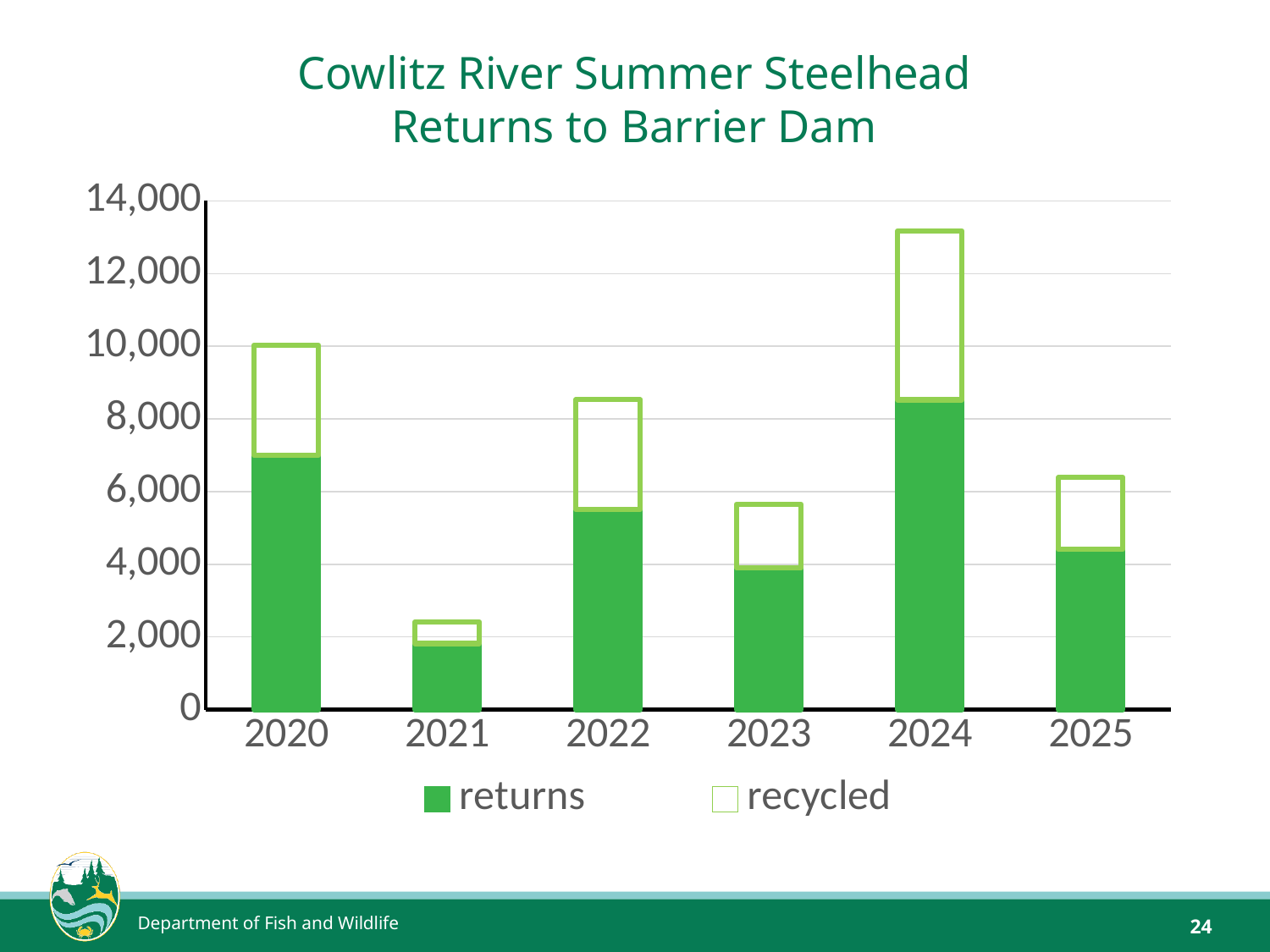
How many years are shown on the x axis of the chart? 6 How many series does the chart's legend list? 2 Is the value for returns in 2020 greater or less than 6,000? greater Which year has the larger value for returns, 2020 or 2022? 2020 What kind of chart is shown on the slide? bar chart Which year has the lowest value for returns? 2021 What are the two series named in the chart's legend? returns and recycled Is the value for returns in 2024 greater or less than 8,000? greater Is the value for returns in 2021 greater or less than 2,000? less Which year has the highest value for returns? 2024 Which year has the lowest total bar (returns plus recycled)? 2021 Which year has the highest total bar (returns plus recycled)? 2024